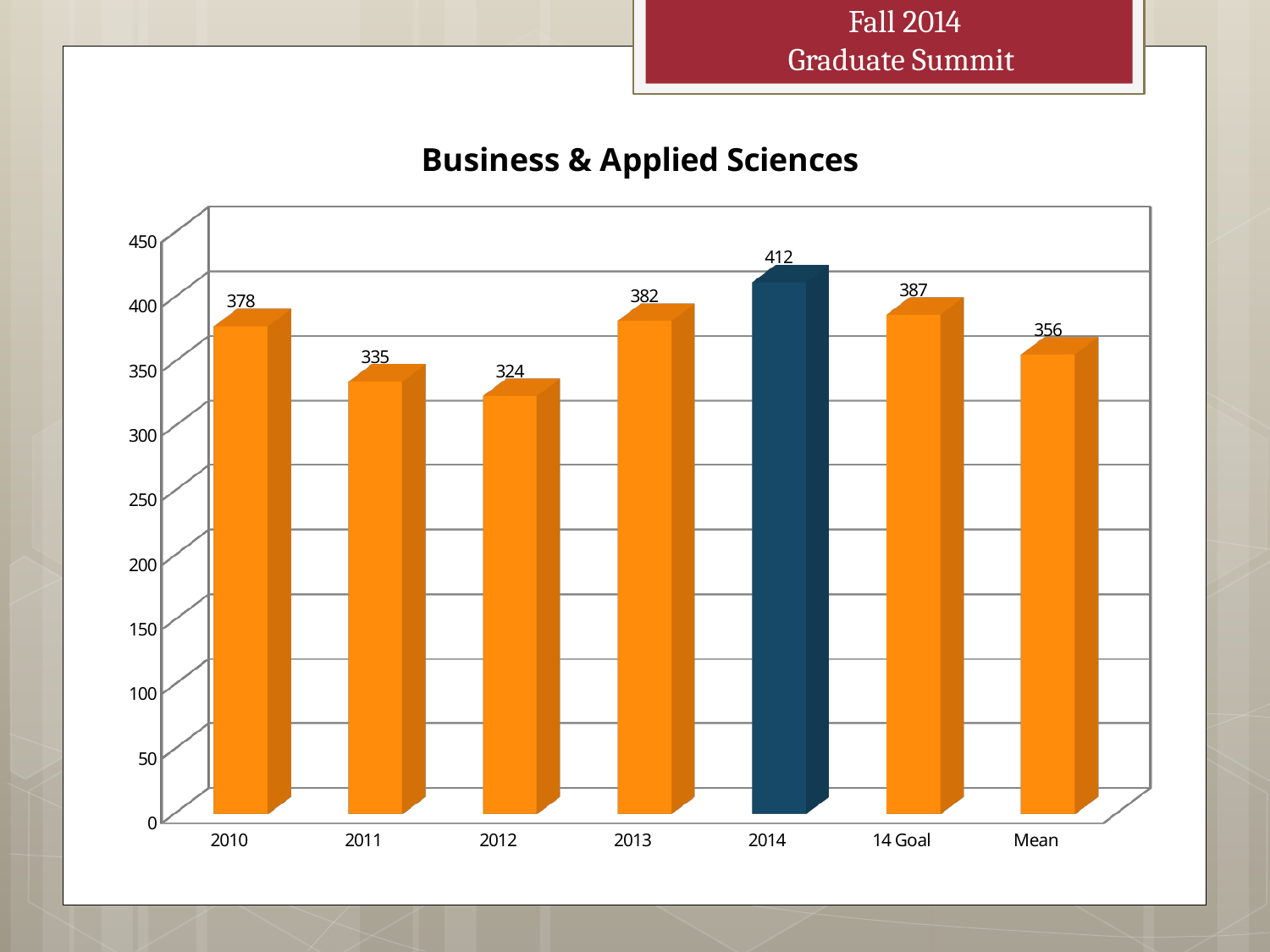
How many categories are shown on the x axis? 7 Which category has the highest value? 2014 What kind of chart is shown? bar chart What is the value for 14 Goal? 387 What is the difference between the 2010 value and the 2011 value? 43 What is the title of the chart? Business & Applied Sciences What is the value for 2014? 412 Which is larger, the value for 2013 or the value for Mean? 2013 Which category has the lowest value? 2012 Is the value for 2011 greater or less than 350? less What is the difference between the 2014 value and the 14 Goal value? 25 What is the value for 2012? 324